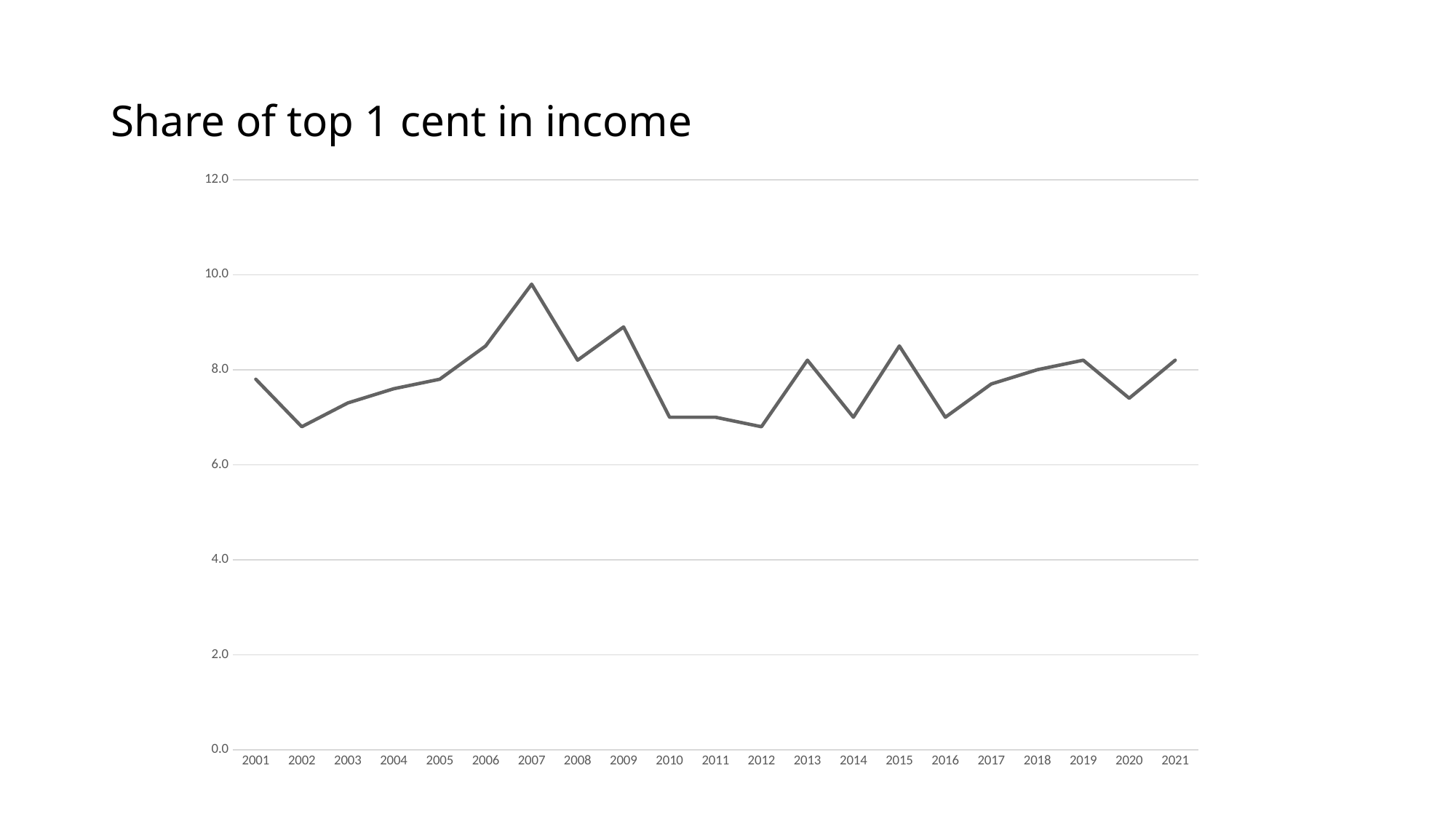
Is the value for 2020 greater or less than 8.0? less Is the value for 2002 greater or less than 8.0? less Is the value for 2007 greater or less than 8.0? greater Which is larger, the value for 2009 or the value for 2016? 2009 Which is larger, the value for 2007 or the value for 2010? 2007 What kind of chart is shown on the slide? line chart What is the title of the chart? Share of top 1 cent in income Which year has the highest value? 2007 How many years are plotted along the x axis? 21 Does the line rise or fall from 2002 to 2007? rise